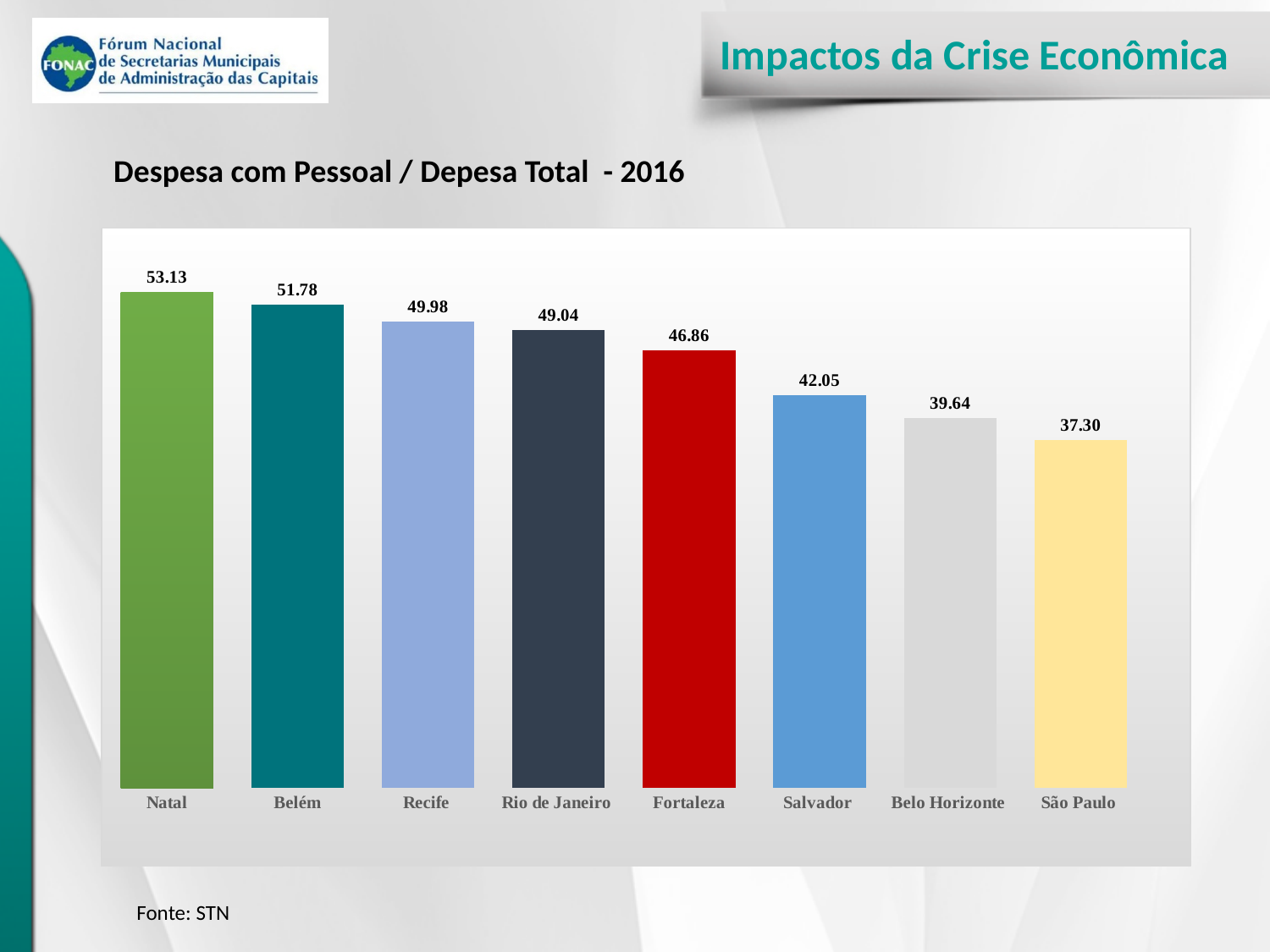
What is the value for Natal? 53.13 Do the values rise or fall from left to right across the cities? Fall What is the title of the chart? Despesa com Pessoal / Depesa Total - 2016 What kind of chart is shown on the slide? Bar chart Which city has the lowest value? São Paulo What is the difference between the values for Recife and Rio de Janeiro? 0.94 Which city has the highest value? Natal What is the difference between the values for Natal and São Paulo? 15.83 How many cities are shown in the chart? 8 What is the value for Belo Horizonte? 39.64 Which is larger, the value for Salvador or the value for Belo Horizonte? Salvador What is the value for Fortaleza? 46.86